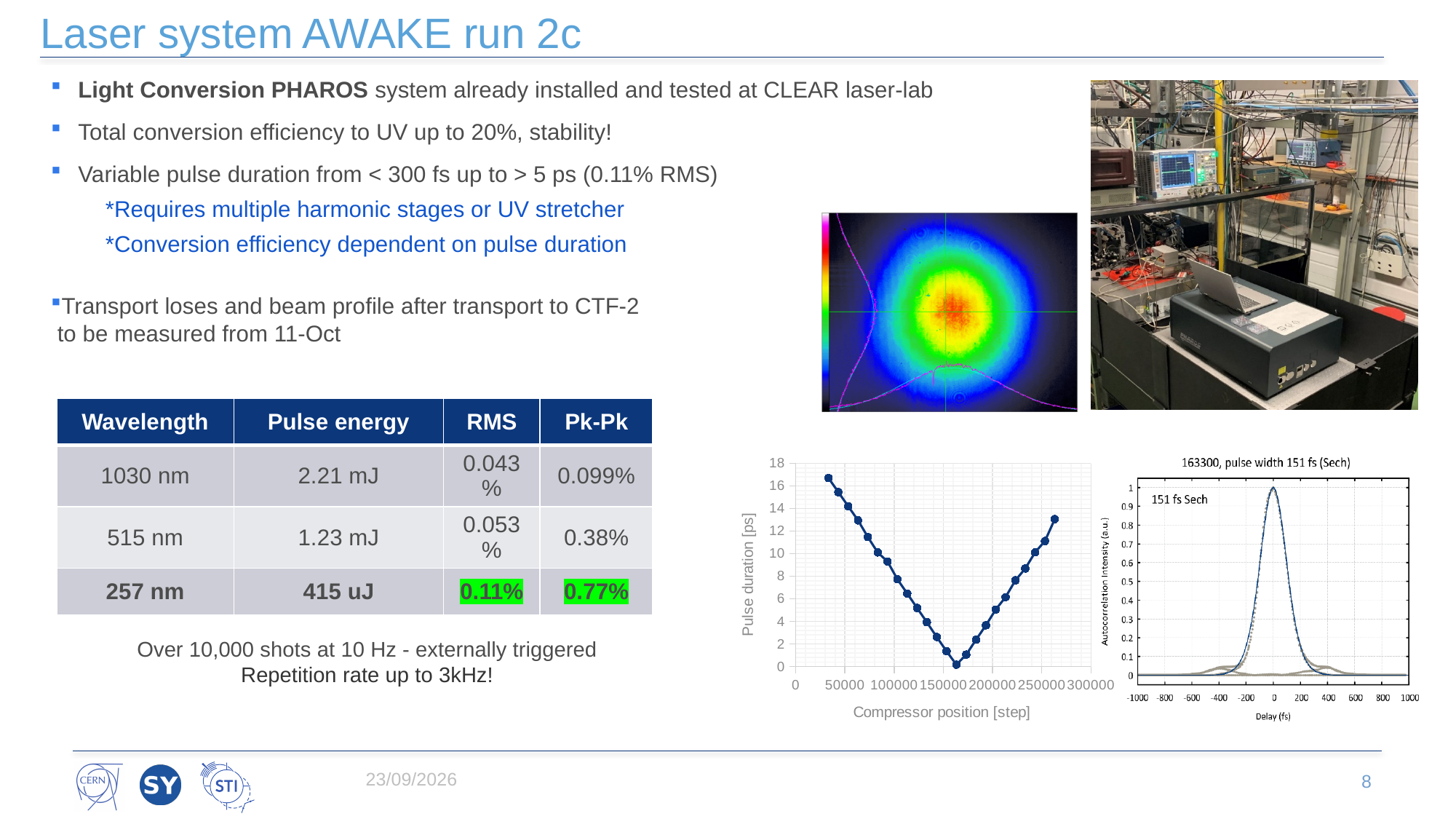
In the chart of pulse duration versus compressor position, is the pulse duration at the leftmost data point greater or less than 14 ps? greater In the chart of pulse duration versus compressor position, what kind of chart is it? line chart In the chart of pulse duration versus compressor position, is the compressor position at which the pulse duration is lowest greater or less than 100000 steps? greater In the chart of pulse duration versus compressor position, which has the larger pulse duration, the leftmost data point or the rightmost data point? the leftmost data point In the chart of pulse duration versus compressor position, do the values rise or fall as the compressor position increases from 200000 to 250000 steps? rise In the chart of pulse duration versus compressor position, do the values rise or fall as the compressor position increases from 50000 to 150000 steps? fall In the chart of pulse duration versus compressor position, is the lowest pulse duration plotted greater or less than 2 ps? less In the chart of pulse duration versus compressor position, what is the label of the y axis? Pulse duration [ps] In the chart of pulse duration versus compressor position, what is the label of the x axis? Compressor position [step] In the autocorrelation chart on the right, what pulse width is stated in the chart title? 151 fs In the chart of pulse duration versus compressor position, what is the highest tick value shown on the y axis? 18